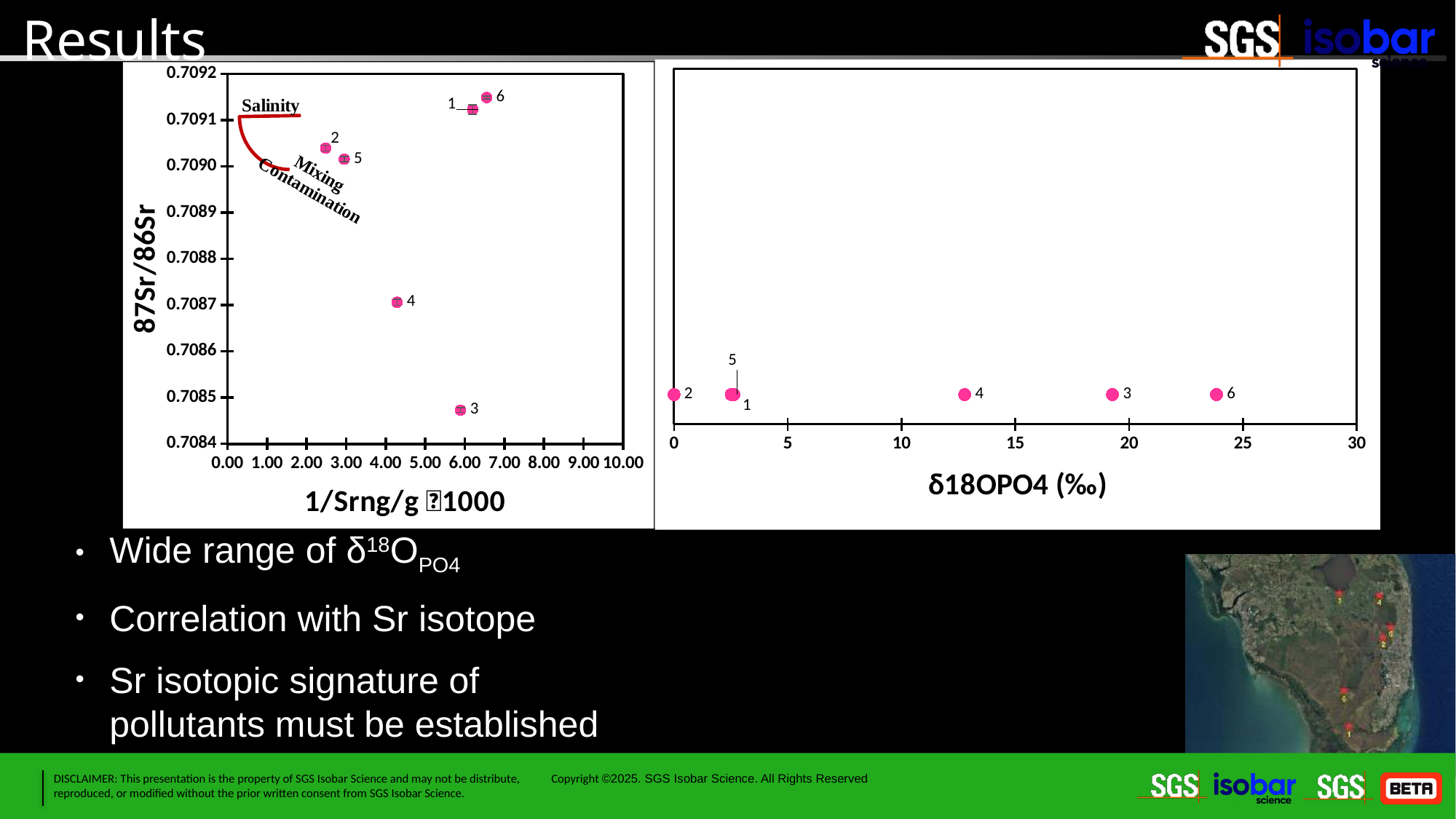
On the left chart (87Sr/86Sr vs 1/Sr), is the 87Sr/86Sr value for point 4 greater or less than 0.7088? less On the left chart (87Sr/86Sr vs 1/Sr), is the 87Sr/86Sr value for point 2 greater or less than 0.7090? greater What kind of chart is the right chart (δ18OPO4)? scatter chart How many data points are plotted on the left chart (87Sr/86Sr vs 1/Sr)? 6 On the right chart (δ18OPO4), which labelled point has the lowest δ18OPO4 value? 2 On the right chart (δ18OPO4), which labelled point has the highest δ18OPO4 value? 6 How many data points are plotted on the right chart (δ18OPO4)? 6 On the right chart (δ18OPO4), is the value for point 4 greater or less than 10? greater On the right chart (δ18OPO4), which has the larger δ18OPO4 value, point 3 or point 4? point 3 On the left chart (87Sr/86Sr vs 1/Sr), which labelled point has the lowest 87Sr/86Sr value? 3 What kind of chart is the left chart (87Sr/86Sr vs 1/Sr)? scatter chart On the left chart (87Sr/86Sr vs 1/Sr), which has the higher 87Sr/86Sr value, point 2 or point 4? point 2